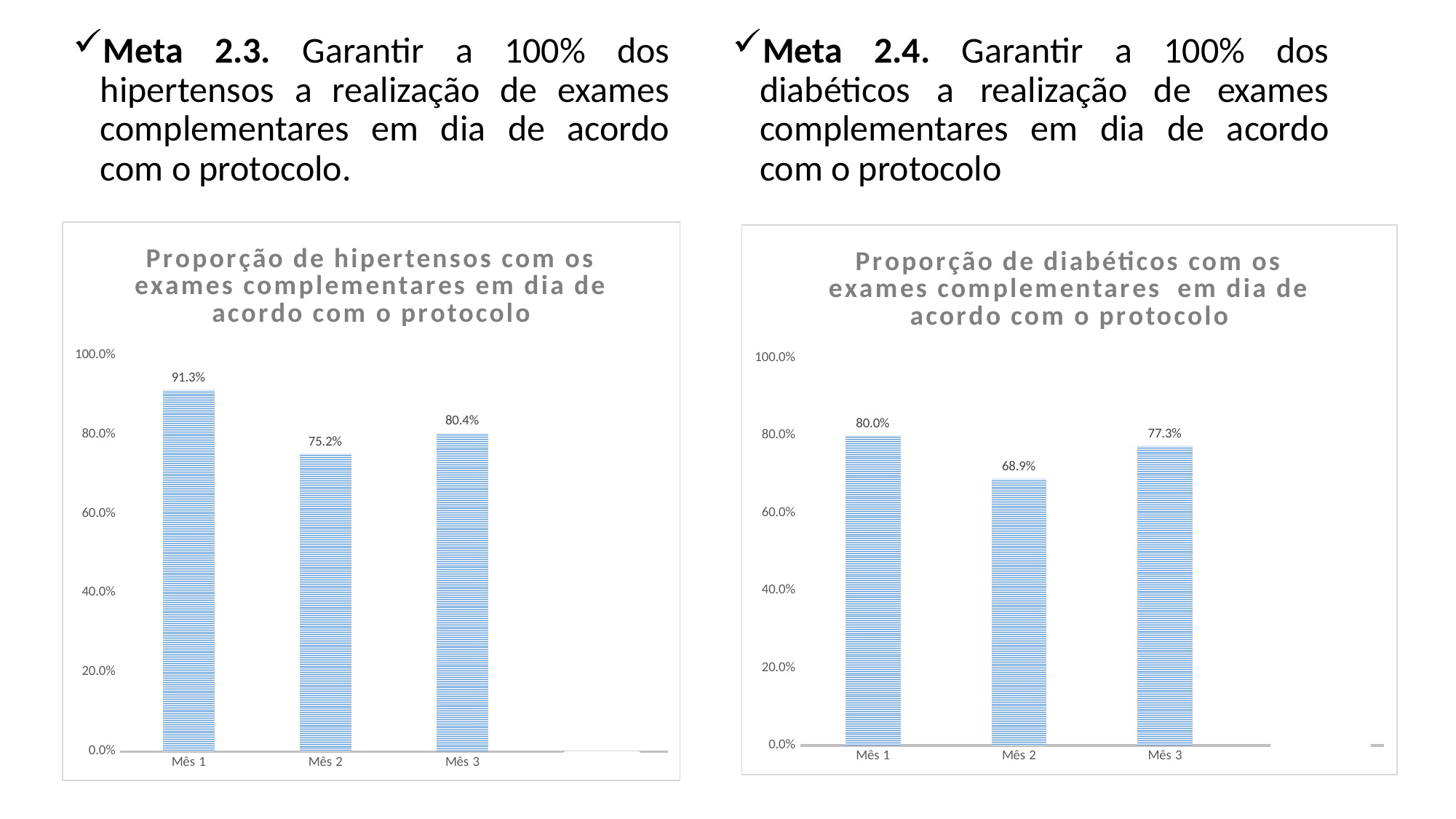
In the left chart (Proporção de hipertensos), is the value for Mês 2 greater or less than 80.0%? less In the right chart (Proporção de diabéticos), which is larger, the value for Mês 1 or Mês 3? Mês 1 In the right chart (Proporção de diabéticos com os exames complementares em dia de acordo com o protocolo), what is the value for Mês 3? 77.3% In the right chart (Proporção de diabéticos), which month has the lowest value? Mês 2 In the left chart (Proporção de hipertensos), what is the difference between the values for Mês 1 and Mês 3? 10.9% In the right chart (Proporção de diabéticos), what is the value for Mês 2? 68.9% In the left chart (Proporção de hipertensos com os exames complementares em dia de acordo com o protocolo), what is the value for Mês 1? 91.3% In the left chart (Proporção de hipertensos), which month has the highest value? Mês 1 In the left chart (Proporção de hipertensos), what is the value for Mês 2? 75.2% In the right chart (Proporção de diabéticos), what is the difference between the values for Mês 1 and Mês 2? 11.1% What kind of chart is the right chart (Proporção de diabéticos)? Bar chart How many bars are plotted in the left chart (Proporção de hipertensos)? 3